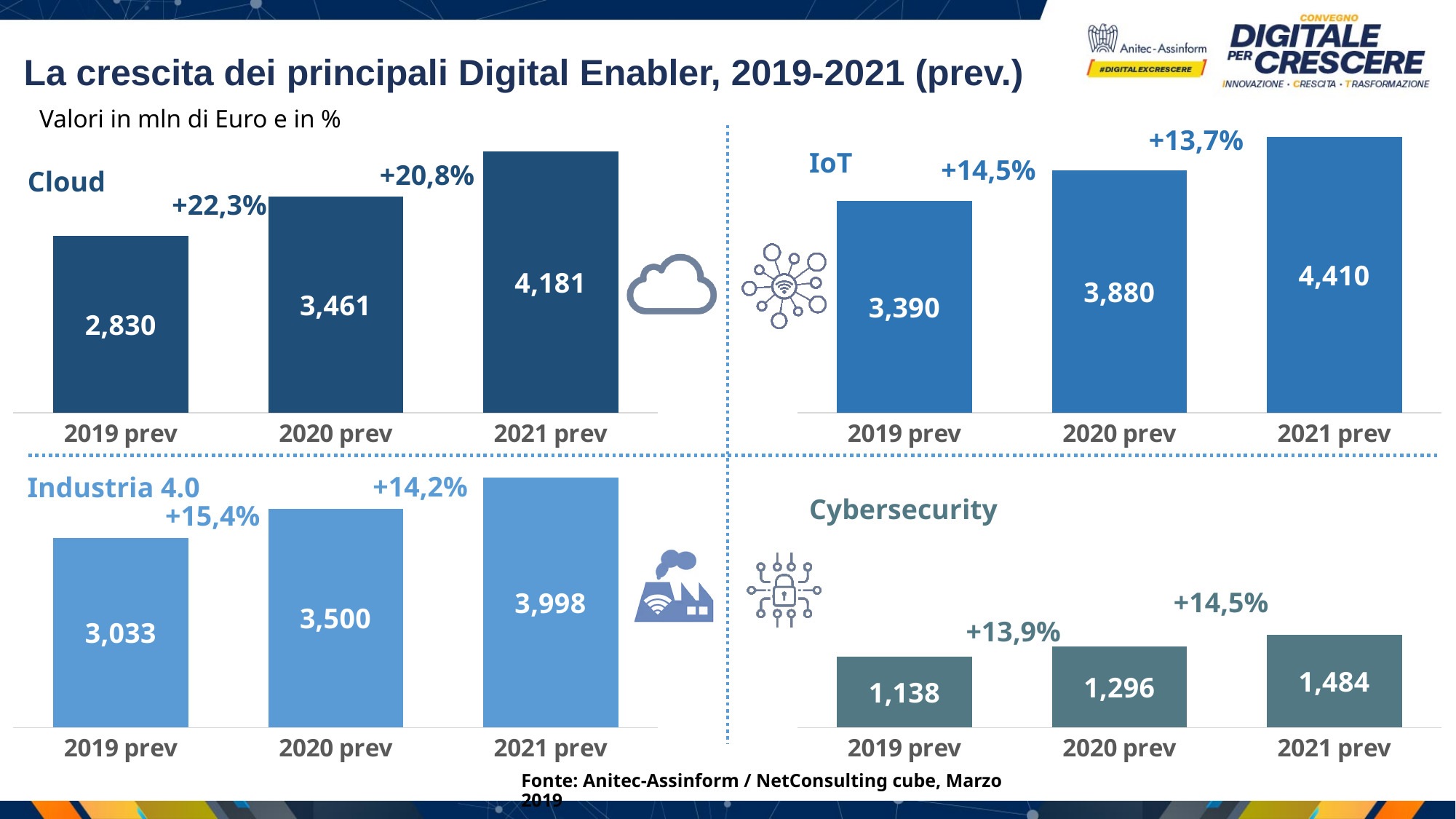
In the IoT chart, what is the difference between the 2021 prev and 2019 prev values? 1,020 In the Industria 4.0 chart, what growth percentage is shown above the 2021 prev bar? +14,2% In the Cloud chart, what is the value for 2019 prev? 2,830 Which is larger: the 2021 prev value in the Cloud chart or the 2021 prev value in the Industria 4.0 chart? Cloud In the Cloud chart, which year has the highest value? 2021 prev How many bars does the Cybersecurity chart have? 3 In the Industria 4.0 chart, what is the difference between the 2020 prev and 2019 prev values? 467 In the Cybersecurity chart, what is the value for 2020 prev? 1,296 What type of chart is the IoT chart? bar chart In the IoT chart, what is the value for 2021 prev? 4,410 In the Cloud chart, do the values rise or fall from 2019 prev to 2021 prev? rise In the Cybersecurity chart, which year has the lowest value? 2019 prev